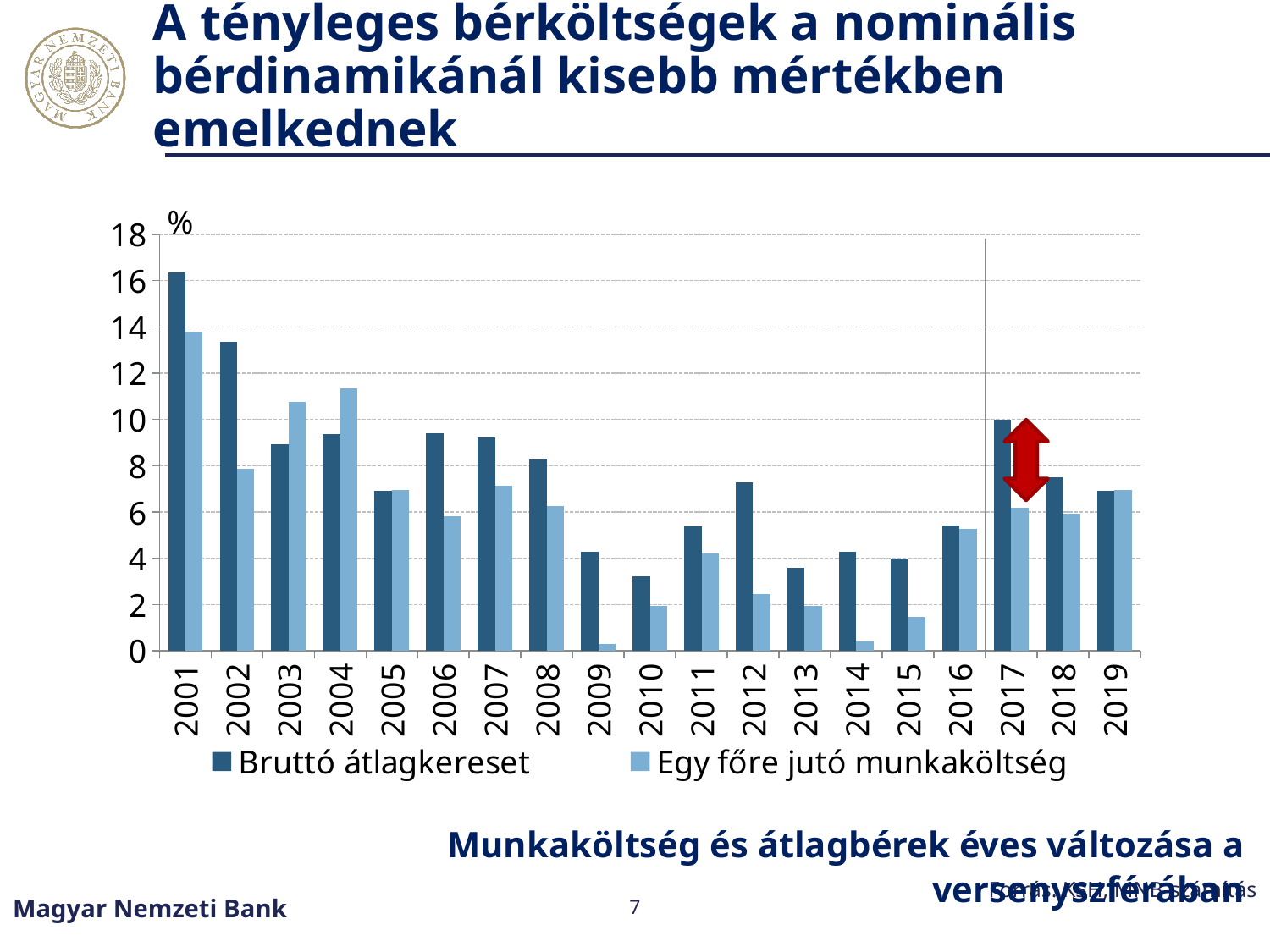
What kind of chart is shown on the slide? bar chart In which year is the Egy főre jutó munkaköltség value lowest? 2009 Is the Bruttó átlagkereset value for 2001 greater or less than 14? greater In which year is the Bruttó átlagkereset value lowest? 2010 In which year is the Bruttó átlagkereset value highest? 2001 In 2003, which series has the larger value: Bruttó átlagkereset or Egy főre jutó munkaköltség? Egy főre jutó munkaköltség What unit is shown at the top of the y axis? % Is the Egy főre jutó munkaköltség value for 2012 greater or less than 4? less In 2012, which series has the larger value: Bruttó átlagkereset or Egy főre jutó munkaköltség? Bruttó átlagkereset How many years are shown on the x axis? 19 Is the Bruttó átlagkereset value for 2017 greater or less than 8? greater How many series does the legend list? 2